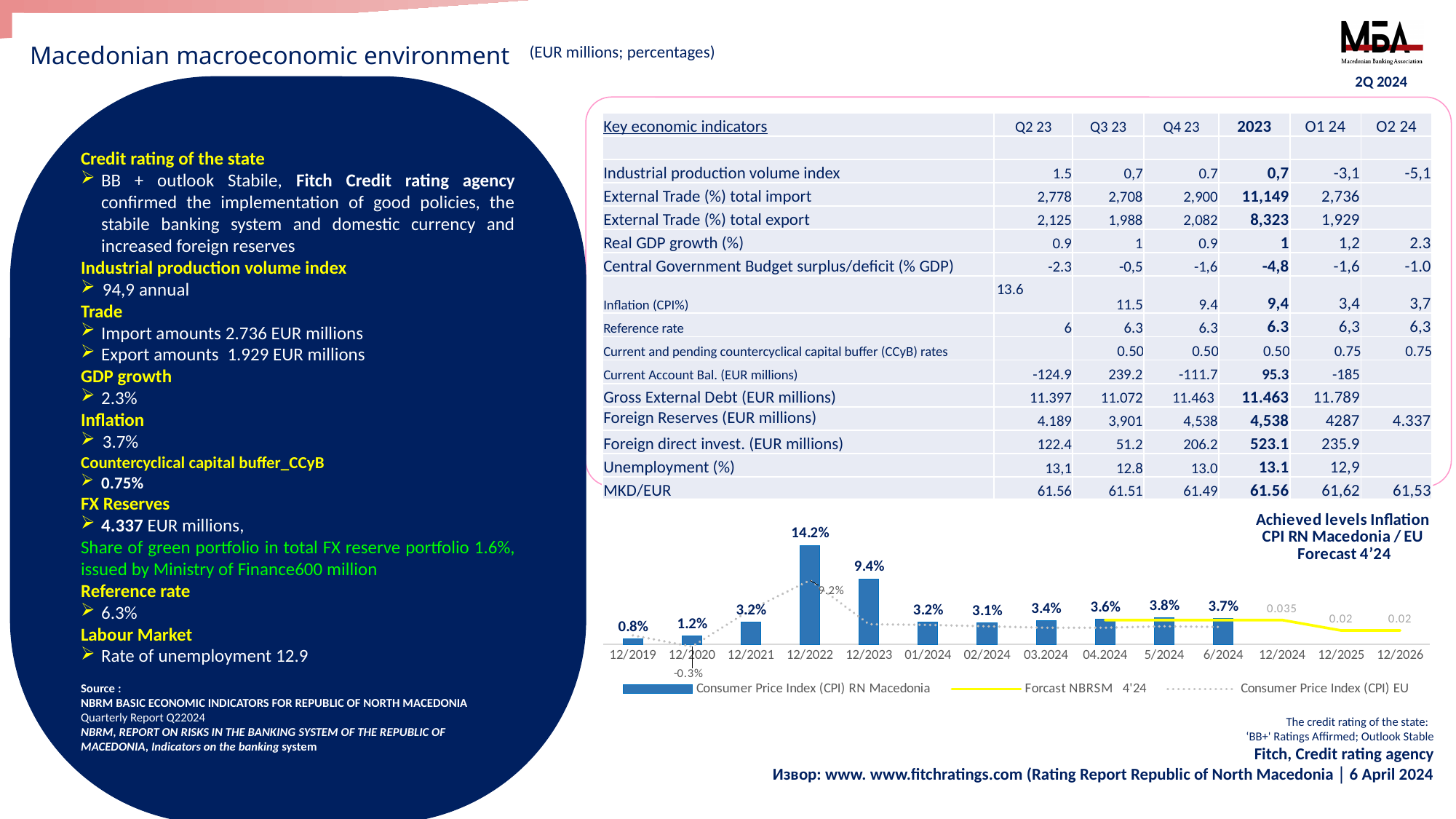
Which period has the lowest Consumer Price Index (CPI) RN Macedonia bar in the inflation chart? 12/2019 What is the value of the Consumer Price Index (CPI) RN Macedonia bar for 12/2022 in the inflation chart? 14.2% What is the value of the Forcast NBRSM 4'24 line for 12/2026 in the inflation chart? 0.02 Which period has the highest Consumer Price Index (CPI) RN Macedonia bar in the inflation chart? 12/2022 What kind of chart is used to show the Consumer Price Index (CPI) RN Macedonia in the inflation chart? Bar chart How many periods are shown on the x axis of the inflation chart? 14 Do the CPI RN Macedonia bars rise or fall from 12/2022 to 12/2023 in the inflation chart? Fall How many series does the legend of the inflation chart list? 3 Which is larger in the inflation chart: the CPI RN Macedonia bar for 5/2024 or for 6/2024? 5/2024 What is the value of the Consumer Price Index (CPI) RN Macedonia bar for 6/2024 in the inflation chart? 3.7% What is the value of the Consumer Price Index (CPI) RN Macedonia bar for 12/2019 in the inflation chart? 0.8% What is the difference between the CPI RN Macedonia values for 12/2022 and 12/2023 in the inflation chart? 4.8%